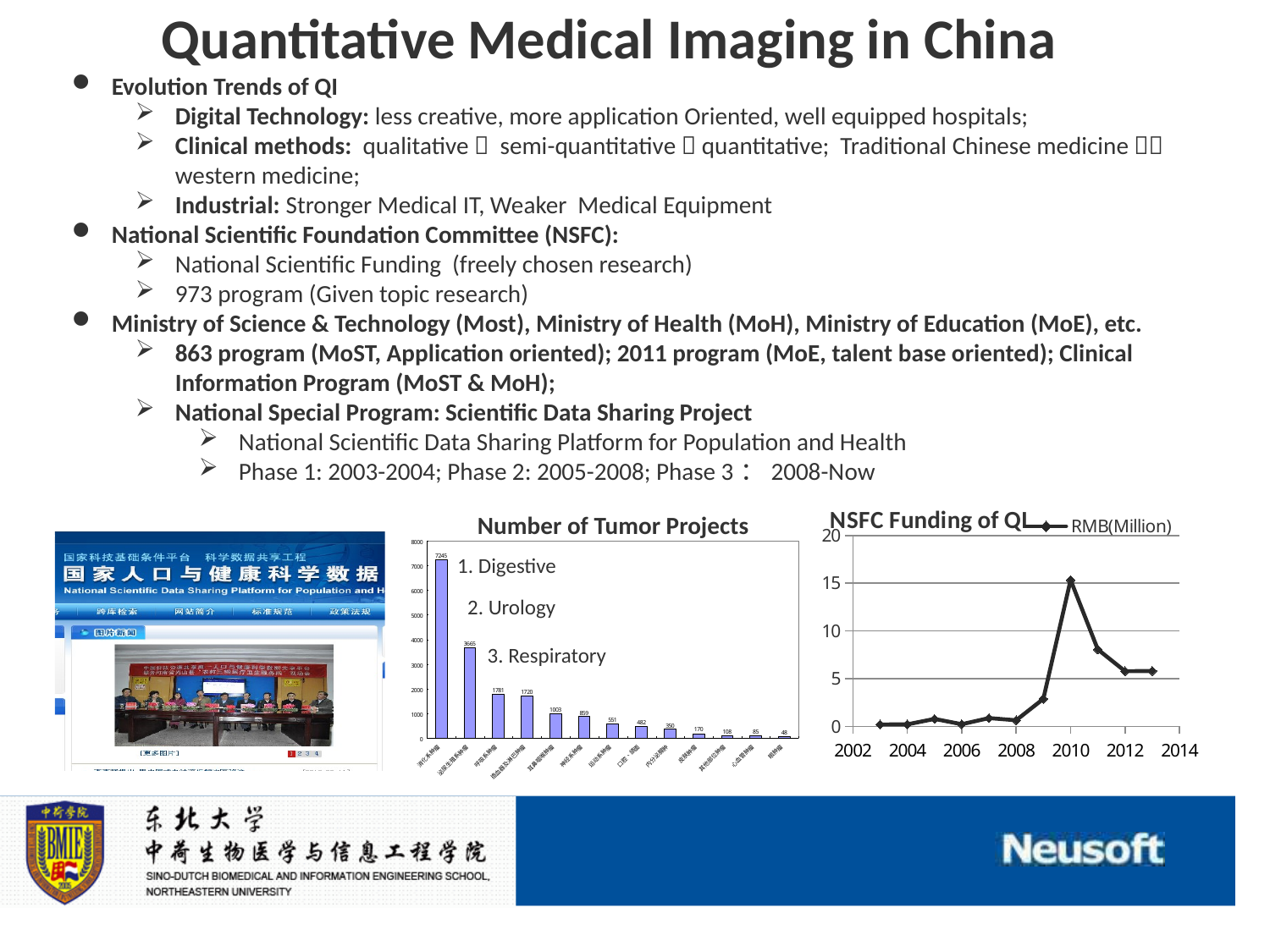
In the 'Number of Tumor Projects' chart, what is the difference between the tallest bar (7245) and the second tallest bar (3665)? 3580 In the 'NSFC Funding of QI' chart, is the value for 2011 greater or less than 10? less In the 'NSFC Funding of QI' chart, is the value for 2010 greater or less than 10? greater In the 'NSFC Funding of QI' chart, which year has the highest funding value? 2010 How many series does the legend of the 'NSFC Funding of QI' chart list? 1 In the 'NSFC Funding of QI' chart, what is the name of the series shown in the legend? RMB(Million) What kind of chart is the 'Number of Tumor Projects' chart? bar chart In the 'Number of Tumor Projects' chart, what is the value of the second tallest bar? 3665 What kind of chart is the 'NSFC Funding of QI' chart? line chart In the 'Number of Tumor Projects' chart, what is the value of the shortest bar? 48 How many bars are plotted in the 'Number of Tumor Projects' chart? 13 In the 'Number of Tumor Projects' chart, what is the value of the tallest bar? 7245